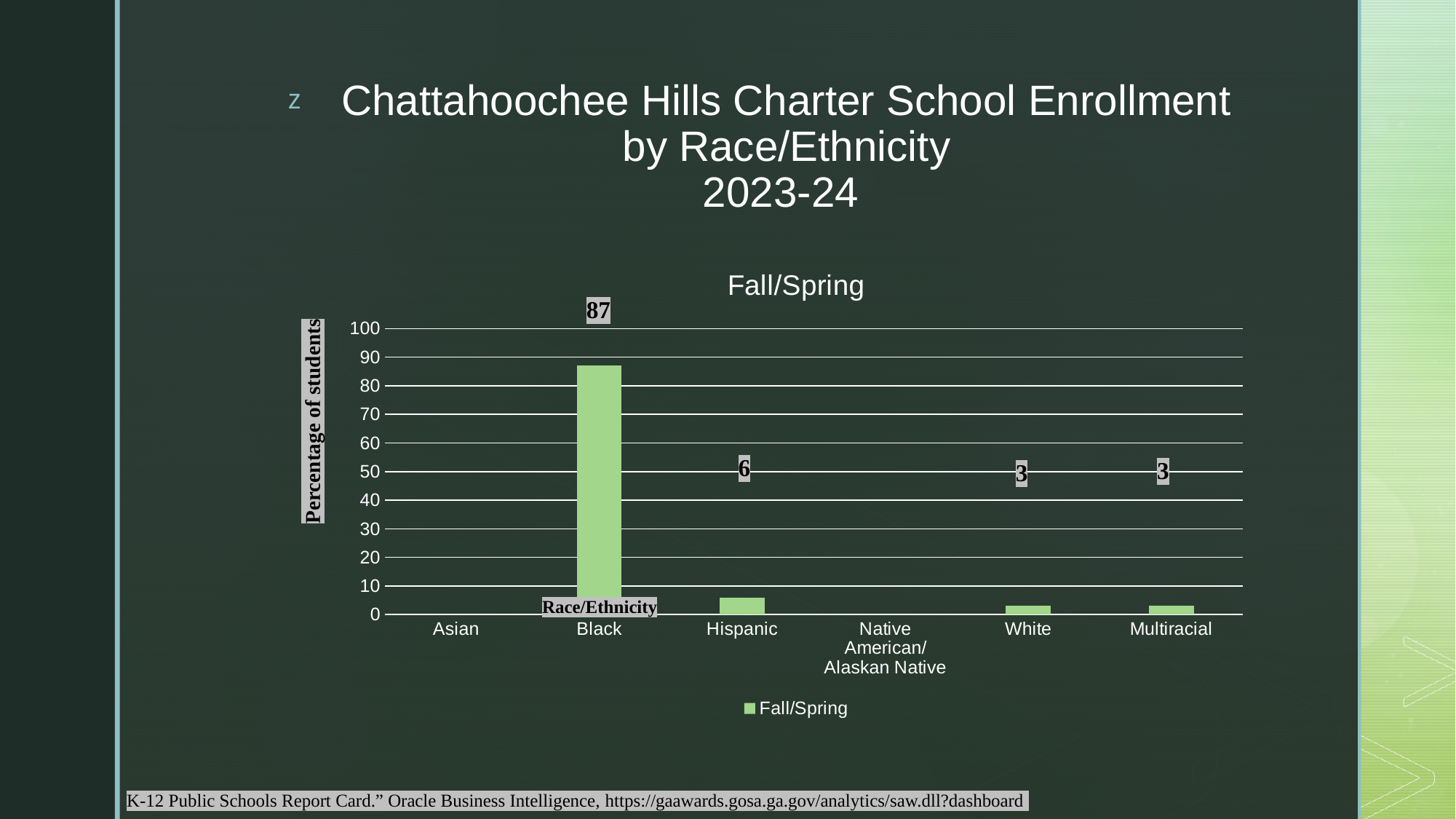
Which is larger, the value for Hispanic or the value for White? Hispanic Is the value for Black greater or less than 80? greater What is the value for White in the Fall/Spring chart? 3 What is the value for Multiracial in the Fall/Spring chart? 3 What is the value for Hispanic in the Fall/Spring chart? 6 How many series does the legend list? 1 How many race/ethnicity categories are shown on the x axis? 6 What kind of chart is shown on the slide? Bar chart Which race/ethnicity category has the highest value? Black What is the difference between the values for Black and Hispanic? 81 What is the difference between the values for Hispanic and White? 3 What is the value for Black in the Fall/Spring chart? 87